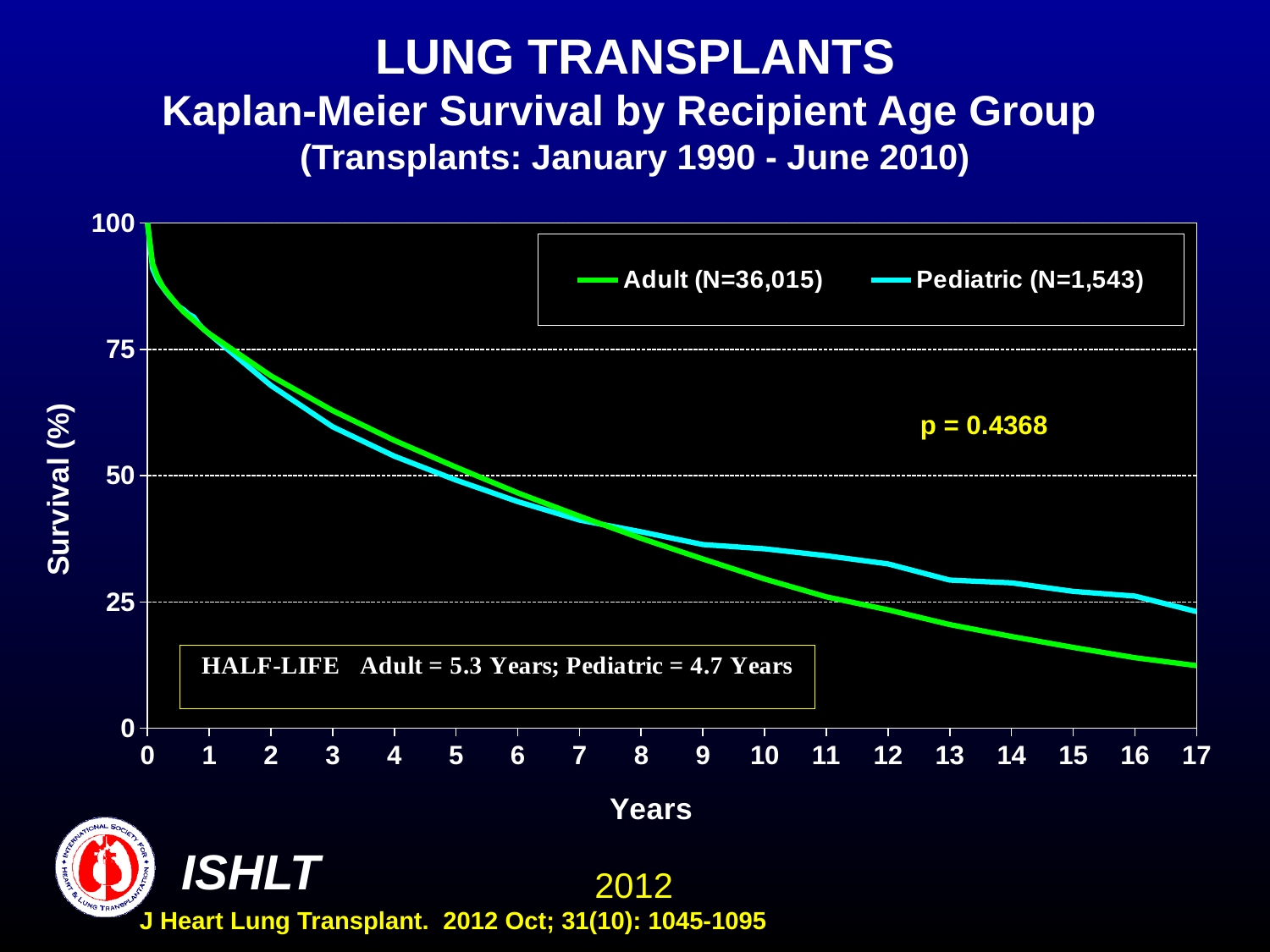
Is the Adult survival at 3 years greater or less than 50? greater Do the survival curves rise or fall as years increase? fall Is the Pediatric survival at 10 years greater or less than 25? greater What kind of chart is shown on the slide? line chart What colour is the Pediatric line? cyan What is the half-life for Adult recipients? 5.3 Years At 16 years, which group has higher survival, Adult or Pediatric? Pediatric How many series does the legend list? 2 What p-value is shown on the chart? p = 0.4368 What is the half-life for Pediatric recipients? 4.7 Years Is the Adult survival at 14 years greater or less than 25? less What is the N for the Adult group in the legend? 36,015